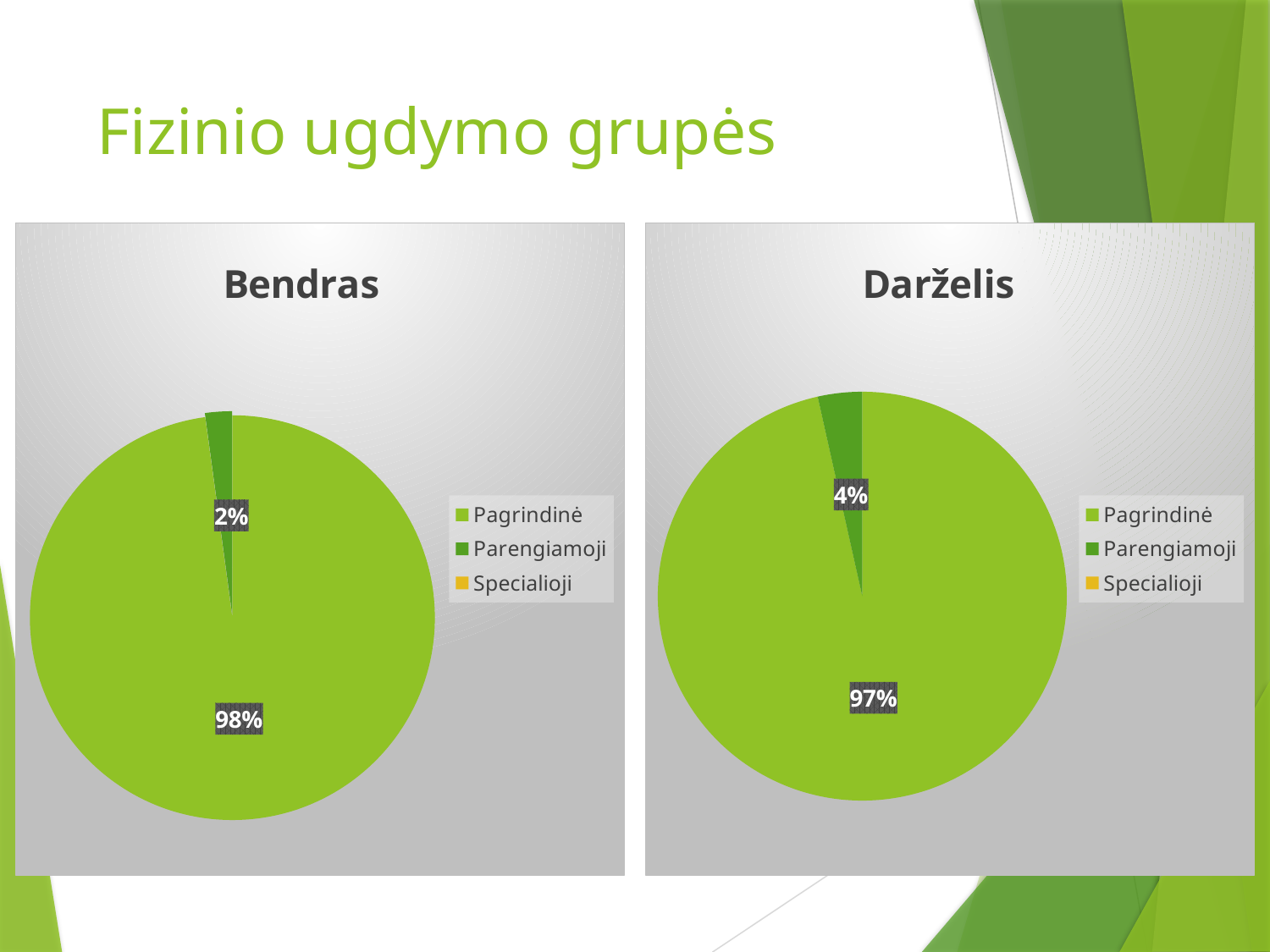
In the "Darželis" chart, which is larger, Pagrindinė or Parengiamoji? Pagrindinė In the "Darželis" chart, what share does Pagrindinė have? 97% In the "Bendras" chart, what share does Pagrindinė have? 98% How many entries does the legend of the "Darželis" chart list? 3 In the "Bendras" chart, what is the difference between the Pagrindinė and Parengiamoji shares? 96% What is the title of the chart on the right side of the slide? Darželis In the "Bendras" chart, which legend entry is shown in orange? Specialioji In the "Bendras" chart, what share does Parengiamoji have? 2% What kind of chart is the "Bendras" chart? Pie chart In the "Bendras" chart, which category has the largest slice? Pagrindinė In the "Darželis" chart, which category has the largest slice? Pagrindinė